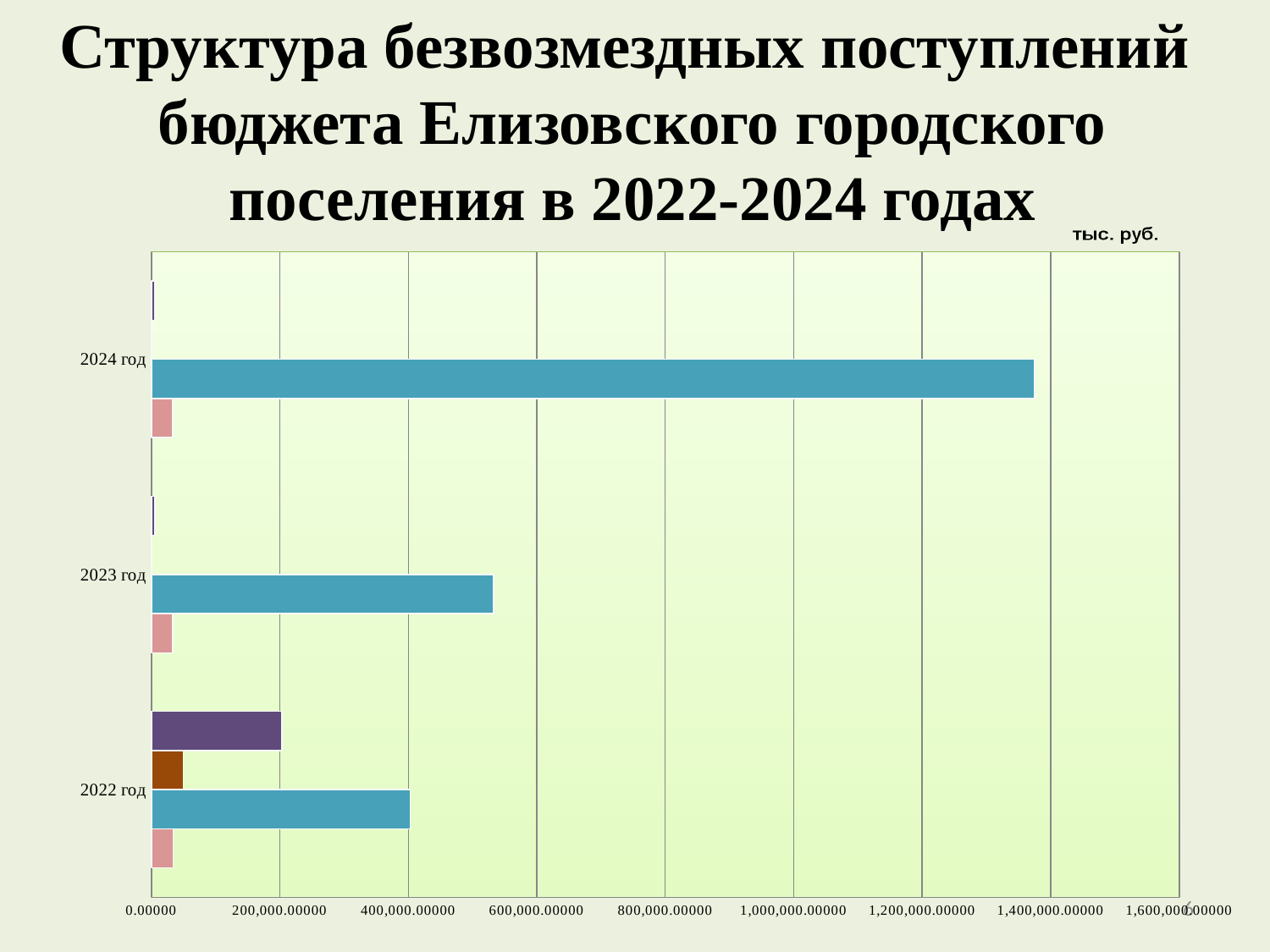
Which year has the shortest teal bar? 2022 год What unit of measurement is indicated above the chart? тыс. руб. Do the teal bars increase or decrease from 2022 год to 2024 год? increase How many year categories are shown on the vertical axis of the chart? 3 How many bars are plotted for the 2022 год category? 4 Which year has the longest teal bar? 2024 год What kind of chart is shown on the slide? bar chart Is the value of the teal bar for 2023 год greater or less than 600,000.00000? less Is the value of the teal bar for 2022 год greater or less than 600,000.00000? less Is the value of the brown bar for 2022 год greater or less than 200,000.00000? less Is the teal bar larger for 2023 год or for 2024 год? 2024 год